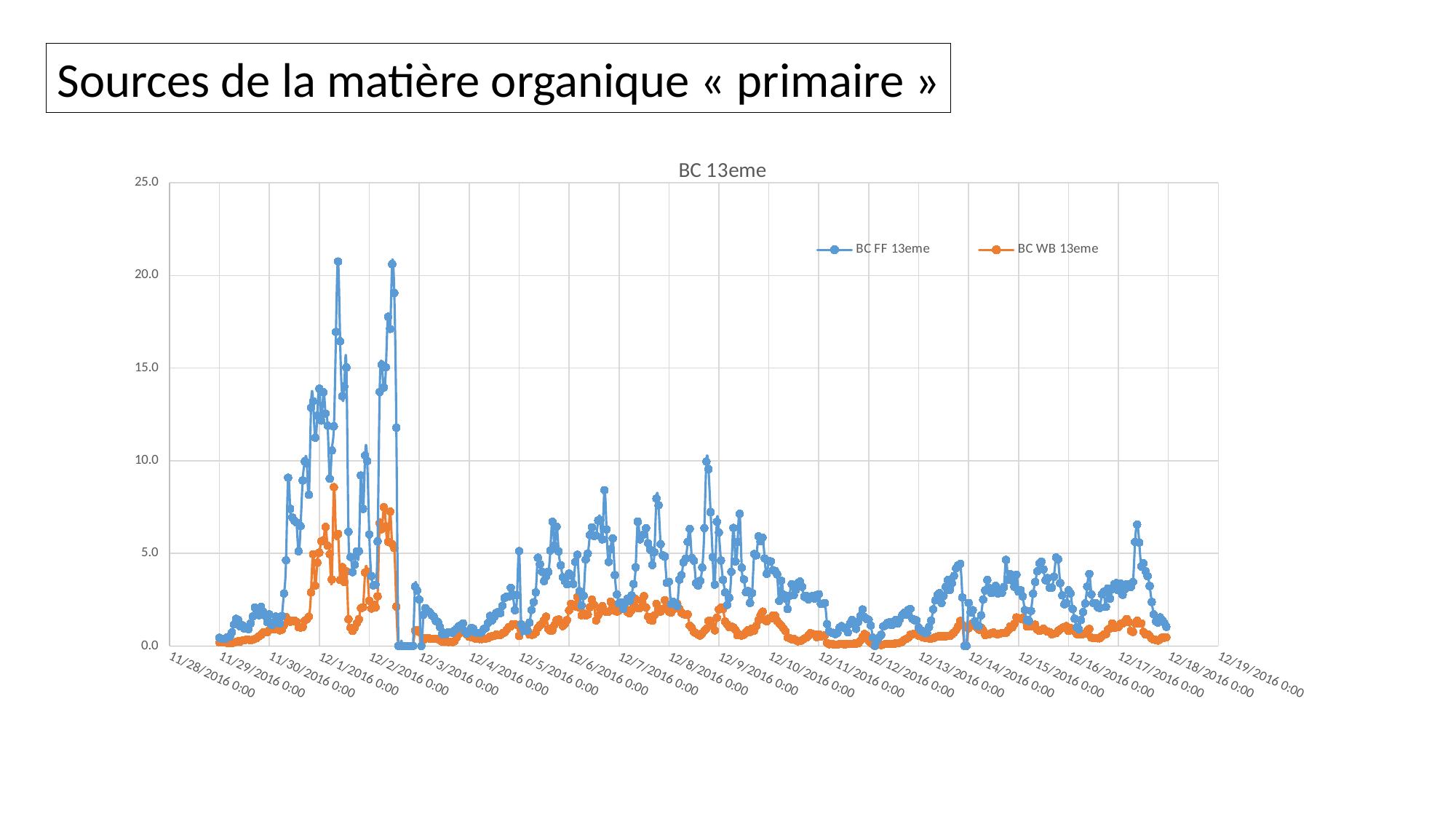
What is the maximum value shown on the vertical axis? 25.0 How many series does the legend list? 2 Is the highest value of BC FF 13eme greater or less than 15.0? greater Which series generally has lower values across the period, BC FF 13eme or BC WB 13eme? BC WB 13eme Is the highest value of BC WB 13eme greater or less than 5.0? greater How many date labels are shown on the horizontal axis? 22 Is the highest value of BC WB 13eme greater or less than 10.0? less What is the title of the chart? BC 13eme Which series reaches the highest value on the chart, BC FF 13eme or BC WB 13eme? BC FF 13eme What type of chart is shown on the slide? line chart Do the largest peaks of BC FF 13eme occur before or after 12/3/2016? before Which series is drawn in orange? BC WB 13eme